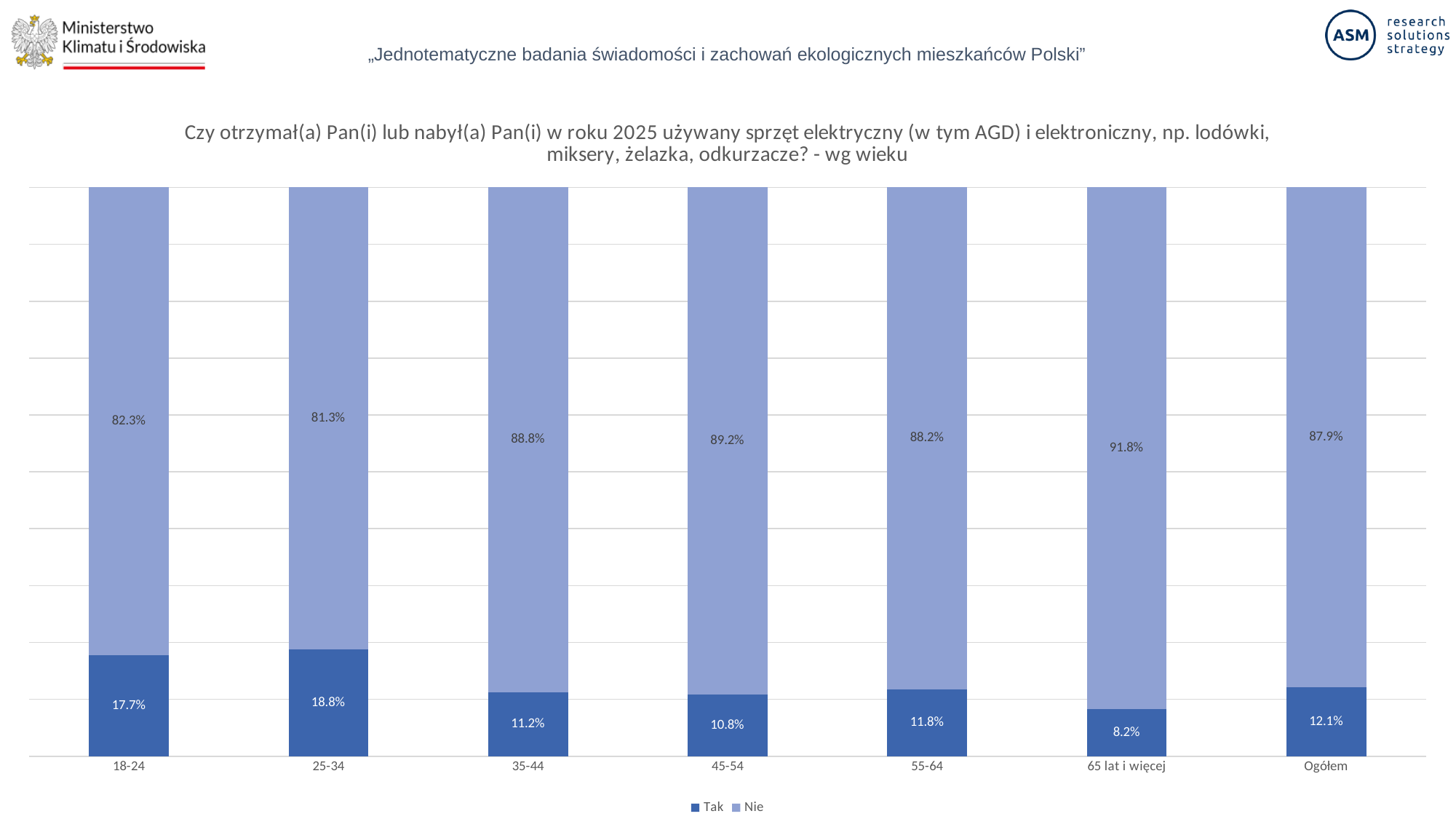
What is the total of the stacked bar for the 55-64 age group? 100.0% Which is larger, the 'Nie' value for 35-44 or for 45-54? 45-54 What is the 'Tak' value for Ogółem? 12.1% What is the 'Nie' value for the 65 lat i więcej age group? 91.8% What is the 'Tak' value for the 18-24 age group? 17.7% Which age group has the lowest 'Tak' value? 65 lat i więcej Which age group has the highest 'Tak' value? 25-34 How many series does the legend list? 2 What are the two legend entries? Tak, Nie What is the difference between the 'Tak' values for 25-34 and 65 lat i więcej? 10.6% How many categories are shown on the x axis? 7 What kind of chart is shown on the slide? Stacked bar chart